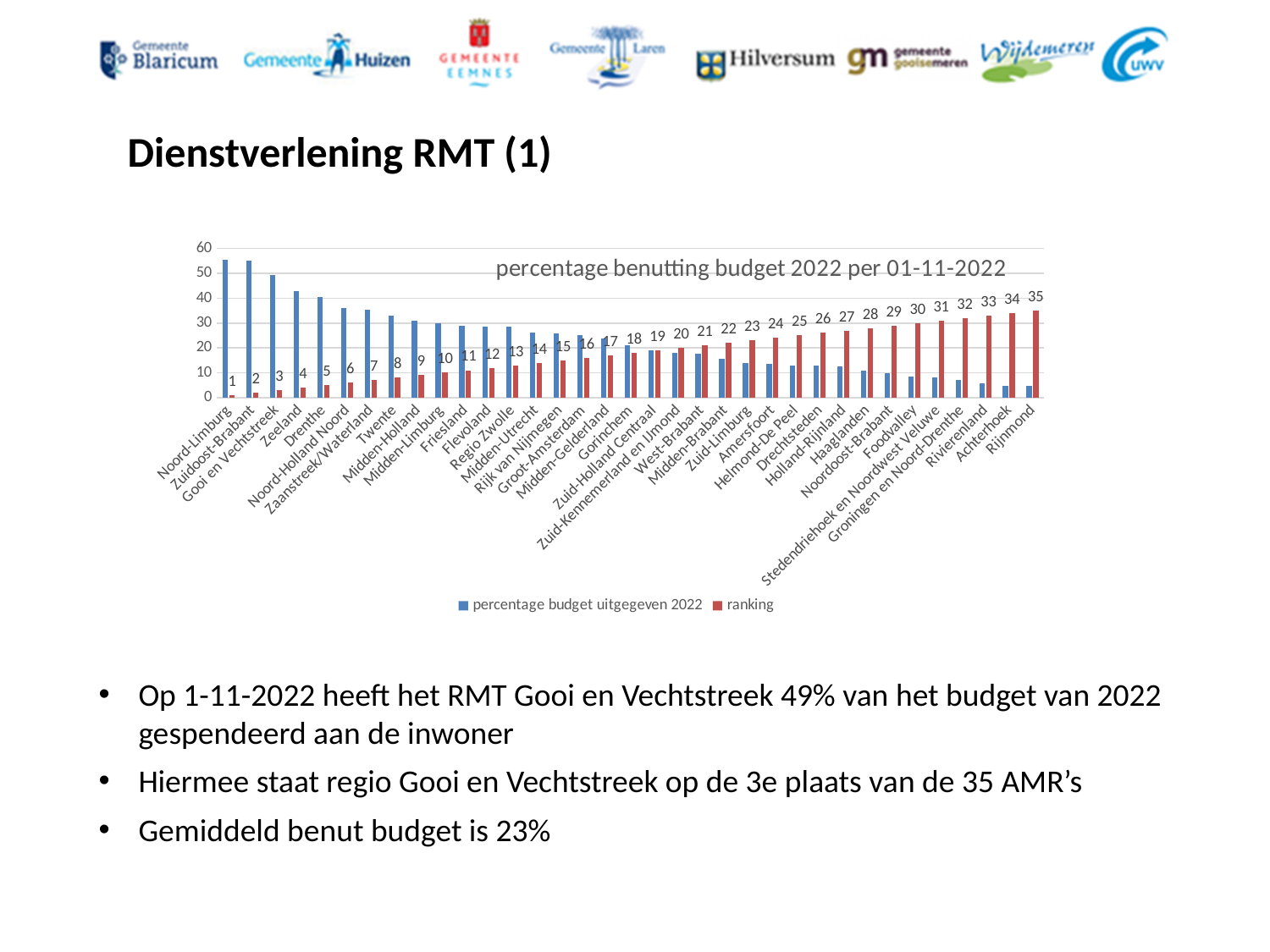
Do the values of the 'percentage budget uitgegeven 2022' series rise or fall from left to right along the x axis? fall What is the difference between the ranking of Rijnmond and the ranking of Noord-Limburg? 34 What is the ranking value for Rijnmond? 35 Which has the larger ranking value, Friesland or Twente? Friesland What is the title of the chart? percentage benutting budget 2022 per 01-11-2022 Is the percentage budget uitgegeven 2022 for Rijnmond greater or less than 10? less How many series does the chart legend list? 2 What kind of chart is shown on the slide? bar chart How many regions (categories) are plotted on the x axis of the chart? 35 Is the percentage budget uitgegeven 2022 for Noord-Limburg greater or less than 50? greater What is the ranking value for Gooi en Vechtstreek? 3 What is the ranking value for Noord-Limburg? 1